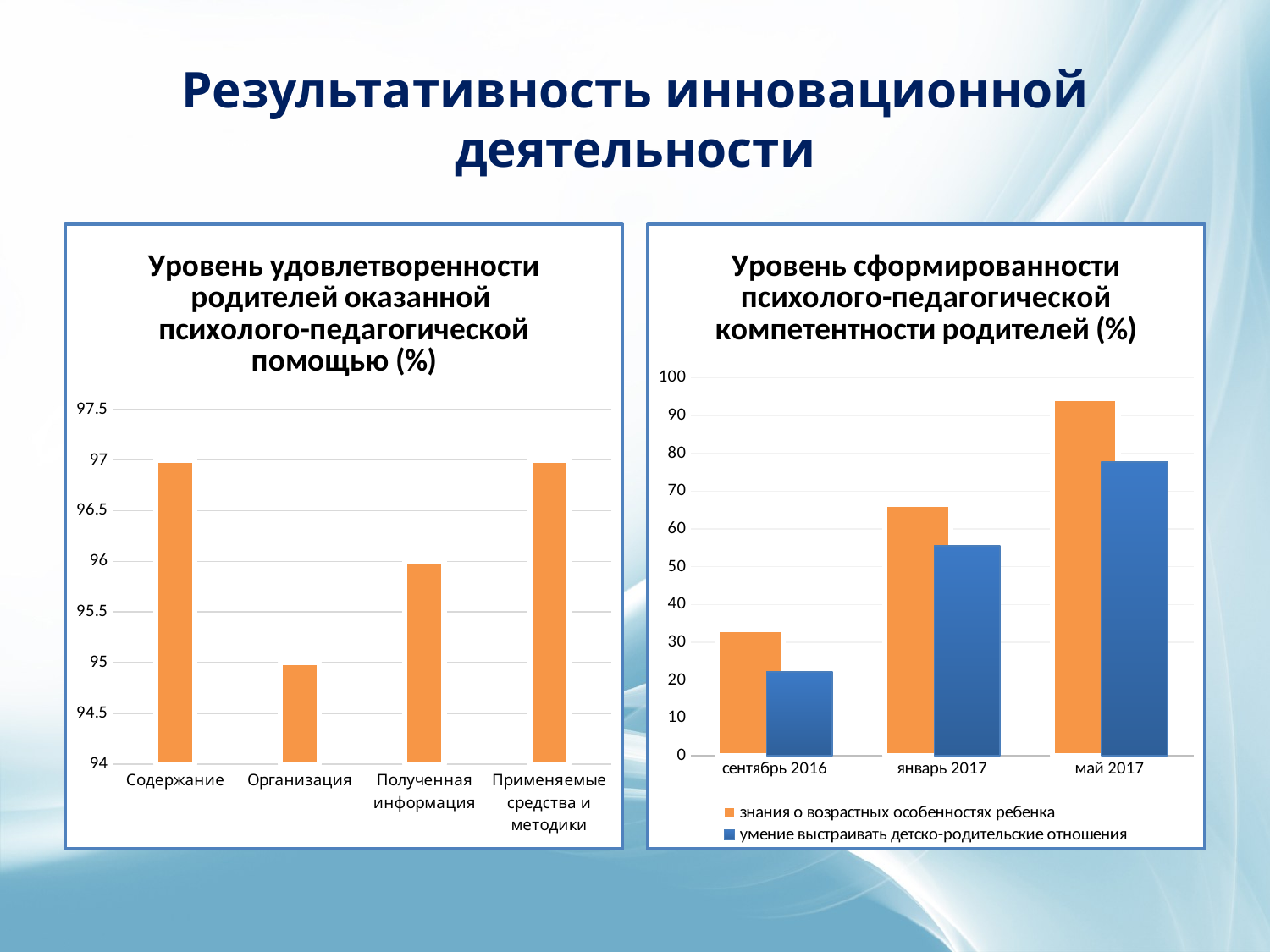
On the right chart, 'Уровень сформированности...', which series is shown in blue? умение выстраивать детско-родительские отношения On the left chart, 'Уровень удовлетворенности родителей...', which category has the lowest value? Организация On the left chart, 'Уровень удовлетворенности родителей...', which is larger: the value for Содержание or the value for Полученная информация? Содержание On the right chart, 'Уровень сформированности...', is the value for 'умение выстраивать детско-родительские отношения' in сентябрь 2016 greater or less than 30? less What kind of chart is the left chart, 'Уровень удовлетворенности родителей оказанной психолого-педагогической помощью (%)'? bar chart On the right chart, 'Уровень сформированности...', do the values for 'знания о возрастных особенностях ребенка' rise or fall from сентябрь 2016 to май 2017? rise How many series does the legend list on the right chart, 'Уровень сформированности психолого-педагогической компетентности родителей (%)'? 2 How many time points are shown on the x axis of the right chart, 'Уровень сформированности психолого-педагогической компетентности родителей (%)'? 3 On the left chart, 'Уровень удовлетворенности родителей...', is the value for Содержание greater or less than 96.5? greater On the left chart, 'Уровень удовлетворенности родителей...', is the value for Организация greater or less than 95.5? less How many categories are shown on the left chart, 'Уровень удовлетворенности родителей оказанной психолого-педагогической помощью (%)'? 4